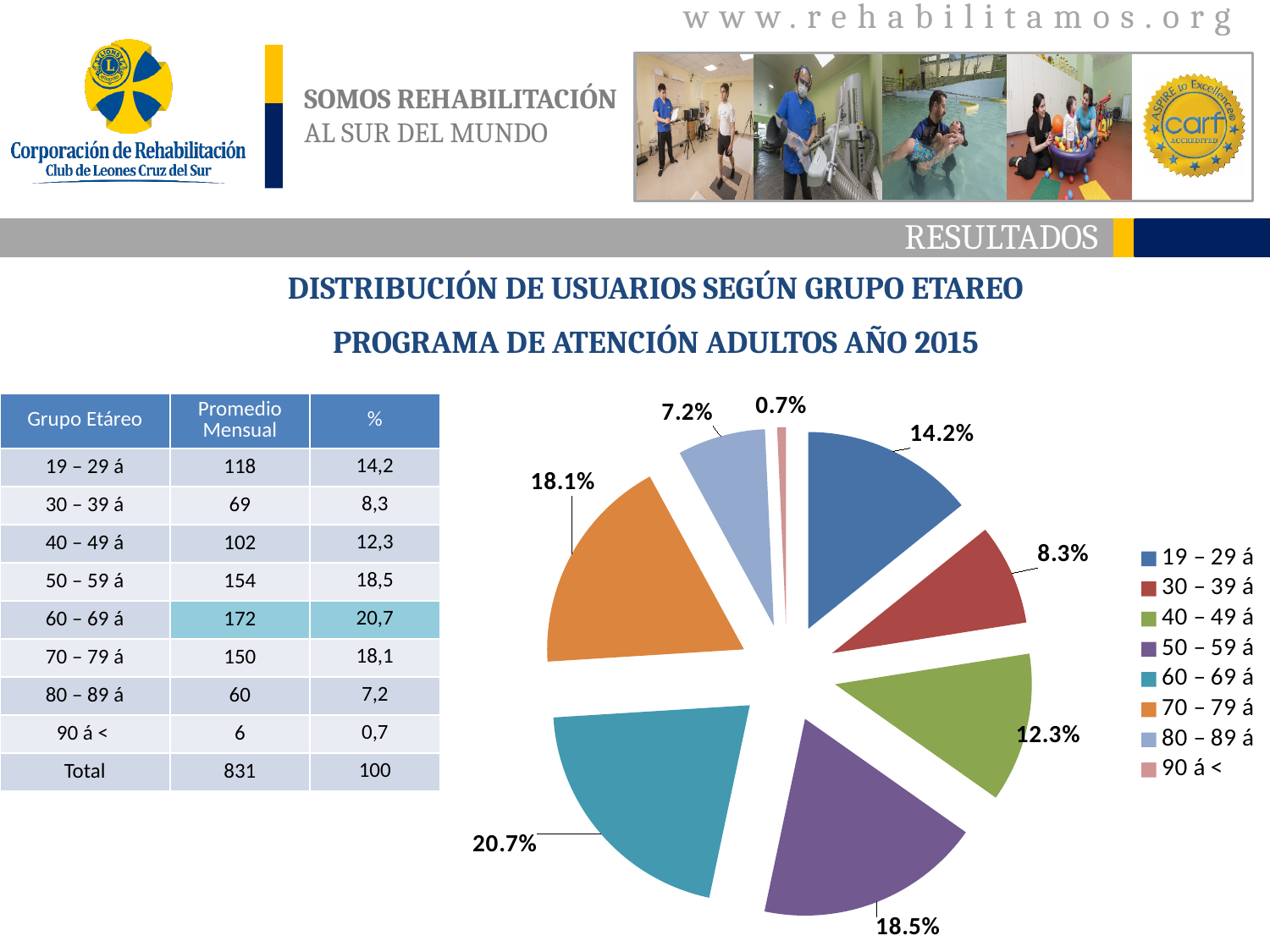
How many entries are listed in the pie chart's legend? 8 Which age group has the smallest slice in the pie chart? 90 á < What percentage of the pie chart corresponds to the 60 – 69 á age group? 20.7% What colour is the slice for the 70 – 79 á age group in the pie chart? orange Which slice is larger in the pie chart: 30 – 39 á or 70 – 79 á? 70 – 79 á Which age group has the largest slice in the pie chart? 60 – 69 á What percentage of the pie chart corresponds to the 40 – 49 á age group? 12.3% What percentage of the pie chart corresponds to the 19 – 29 á age group? 14.2% What is the difference in percentage points between the 50 – 59 á slice and the 30 – 39 á slice? 10.2 How many slices does the pie chart have? 8 What type of chart is shown on the slide? pie chart What percentage of the pie chart corresponds to the 80 – 89 á age group? 7.2%